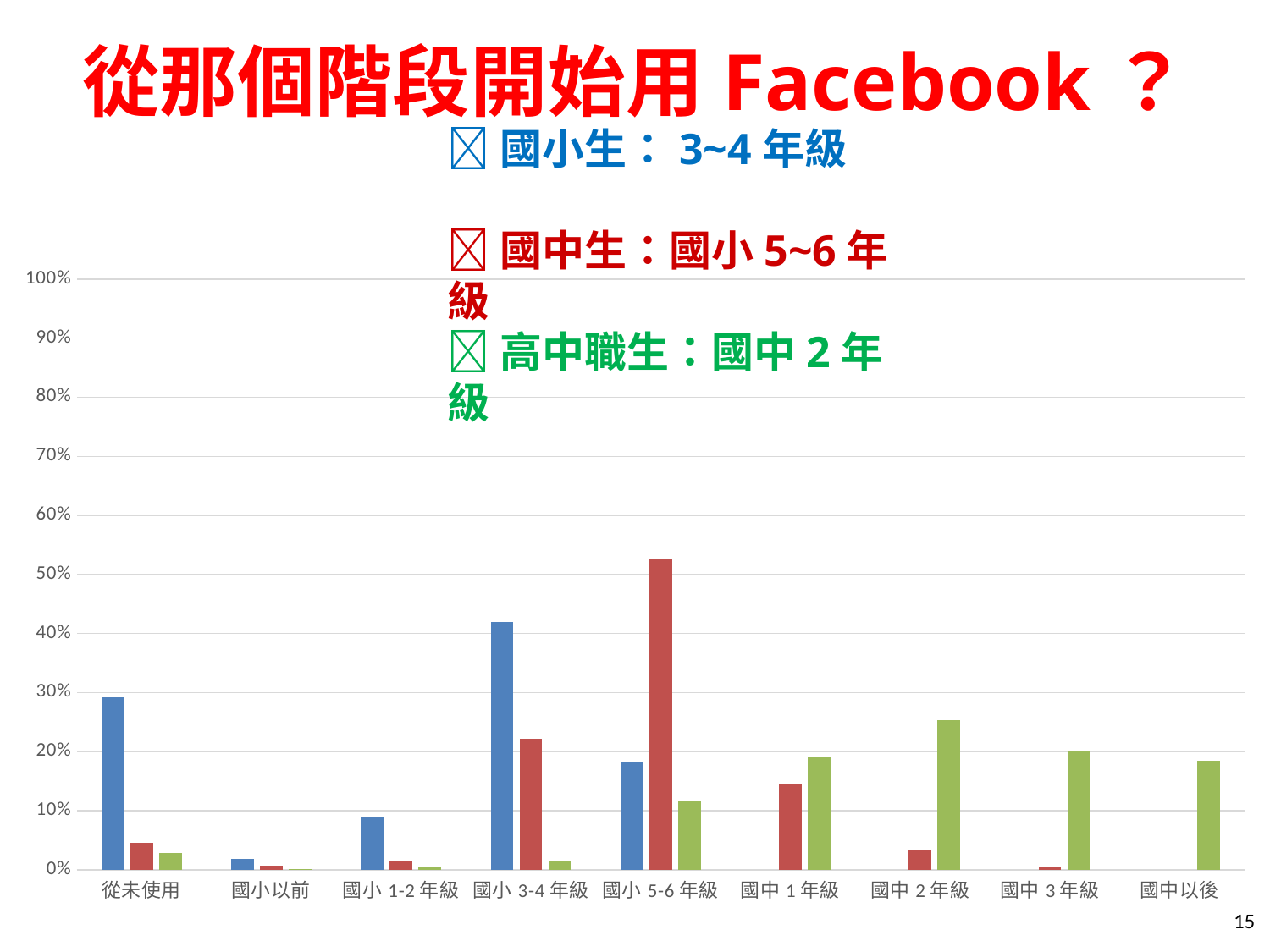
What kind of chart is shown on the slide? bar chart At 國中 1 年級, which is larger, the red bar or the green bar? the green bar Is the blue bar for 國小 1-2 年級 greater or less than 10%? less Among the blue bars, which category is highest? 國小 3-4 年級 Among the green bars, which category is highest? 國中 2 年級 Which category has the tallest bar in the chart? 國小 5-6 年級 Is the green bar for 國中 2 年級 greater or less than 20%? greater How many categories are shown along the x axis of the chart? 9 At 國小 3-4 年級, which is larger, the blue bar or the red bar? the blue bar Is the blue bar for 從未使用 greater or less than 20%? greater What is the title of the slide containing the chart? 從那個階段開始用 Facebook ？